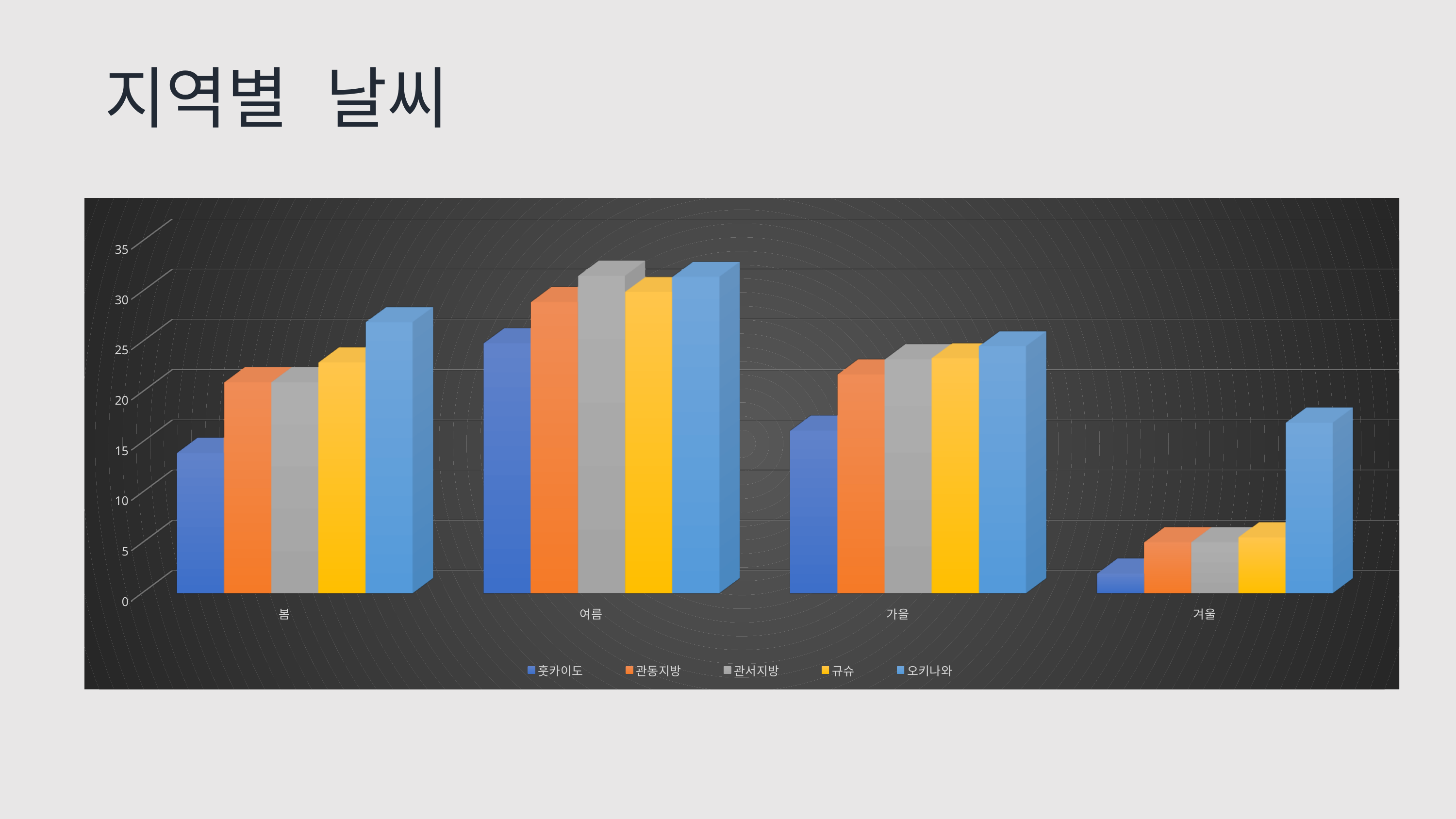
In the 겨울 category, which series has the lowest value? 훗카이도 What is the title of the slide? 지역별 날씨 In which category is the value for 훗카이도 the highest? 여름 Which series is shown in yellow in the legend? 규슈 What kind of chart is shown on the slide? bar chart Is the value for 훗카이도 in 겨울 greater or less than 5? less In the 봄 category, which series has the lowest value? 훗카이도 How many series does the legend list? 5 Is the value for 오키나와 in 겨울 greater or less than 15? greater In the 봄 category, which is larger: 오키나와 or 훗카이도? 오키나와 In the 겨울 category, which series has the highest value? 오키나와 How many categories are shown on the x axis? 4